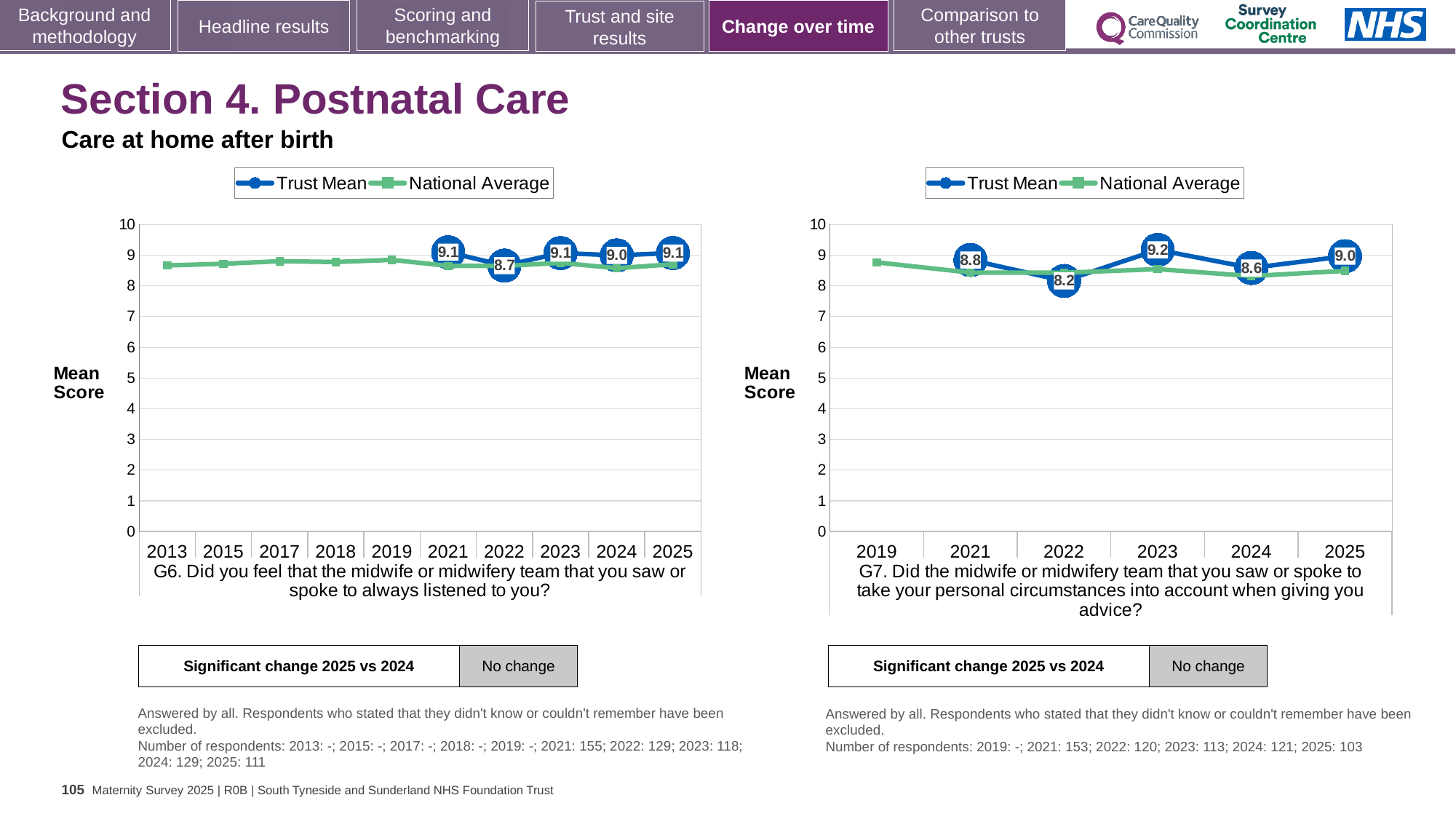
In the left chart (G6), how many years are shown on the x axis? 10 In the right chart (G7), what is the difference between the Trust Mean in 2023 and in 2022? 1.0 In the left chart (G6), what is the Trust Mean for 2025? 9.1 In the left chart (G6), which year has the lowest Trust Mean? 2022 In the right chart (G7), what is the Trust Mean for 2023? 9.2 In the right chart (G7), is the National Average for 2019 greater or less than 8? greater In the right chart (G7), what is the Trust Mean for 2022? 8.2 In the left chart (G6), what is the Trust Mean for 2022? 8.7 In the right chart (G7), is the Trust Mean for 2024 greater or less than the Trust Mean for 2025? less In the left chart (G6), what is the difference between the Trust Mean in 2023 and in 2022? 0.4 How many series does the legend of the right chart (G7) list? 2 In the right chart (G7), which year has the highest Trust Mean? 2023